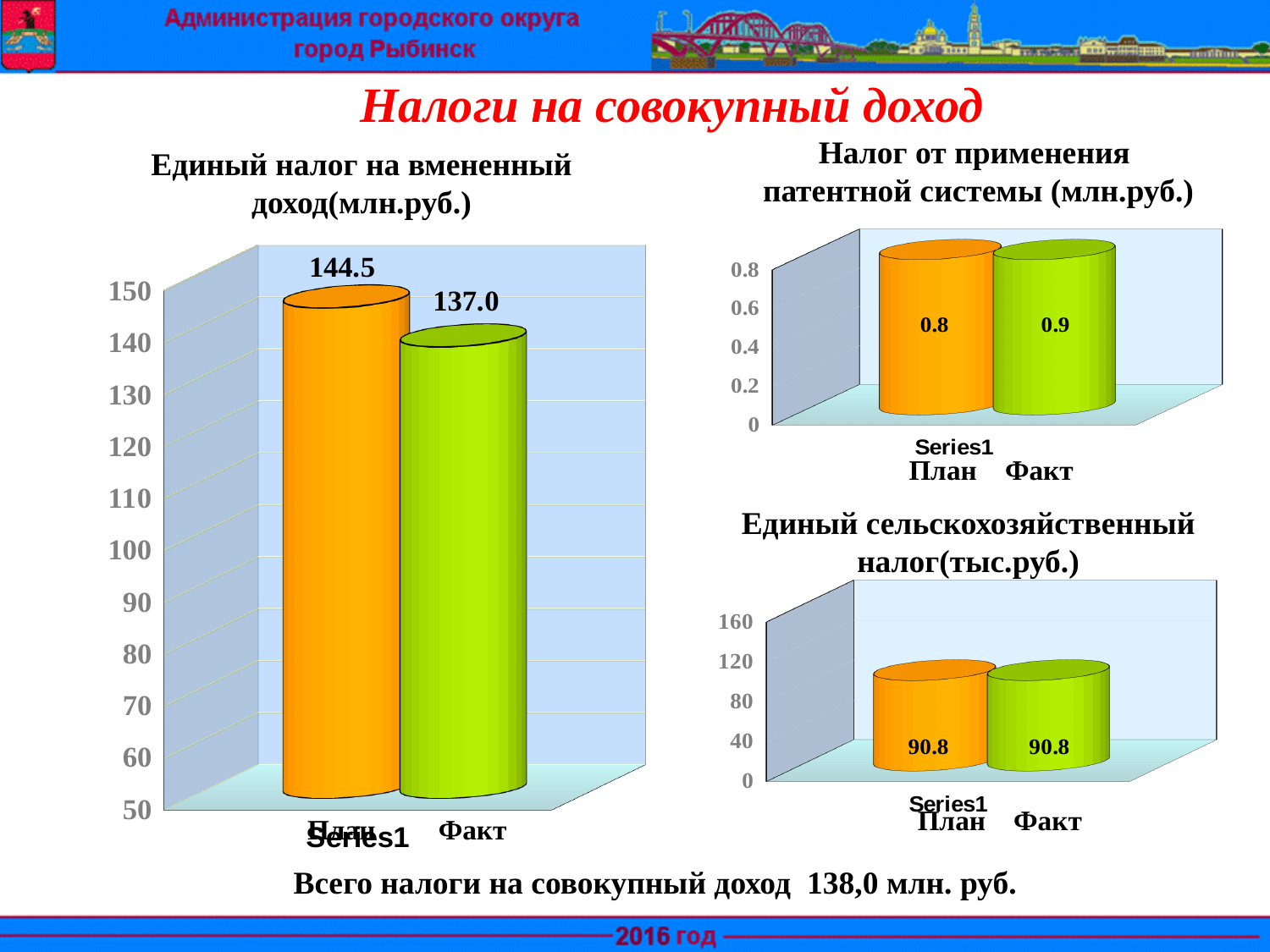
What kind of chart is 'Единый налог на вмененный доход(млн.руб.)'? bar chart In the chart 'Единый налог на вмененный доход(млн.руб.)', which is larger, План or Факт? План In the chart 'Налог от применения патентной системы (млн.руб.)', what is the value for Факт? 0.9 In the chart 'Единый налог на вмененный доход(млн.руб.)', what is the value for План? 144.5 In the chart 'Единый налог на вмененный доход(млн.руб.)', what is the difference between План and Факт? 7.5 In the chart 'Единый сельскохозяйственный налог(тыс.руб.)', what is the value for План? 90.8 In the chart 'Налог от применения патентной системы (млн.руб.)', what is the value for План? 0.8 How many bars are plotted in the chart 'Единый сельскохозяйственный налог(тыс.руб.)'? 2 In the chart 'Единый сельскохозяйственный налог(тыс.руб.)', is the value for Факт greater than, less than, or equal to the value for План? equal In the chart 'Единый налог на вмененный доход(млн.руб.)', what is the value for Факт? 137.0 In the chart 'Налог от применения патентной системы (млн.руб.)', which category has the highest value? Факт In the chart 'Единый налог на вмененный доход(млн.руб.)', is the value for Факт greater or less than 130? greater